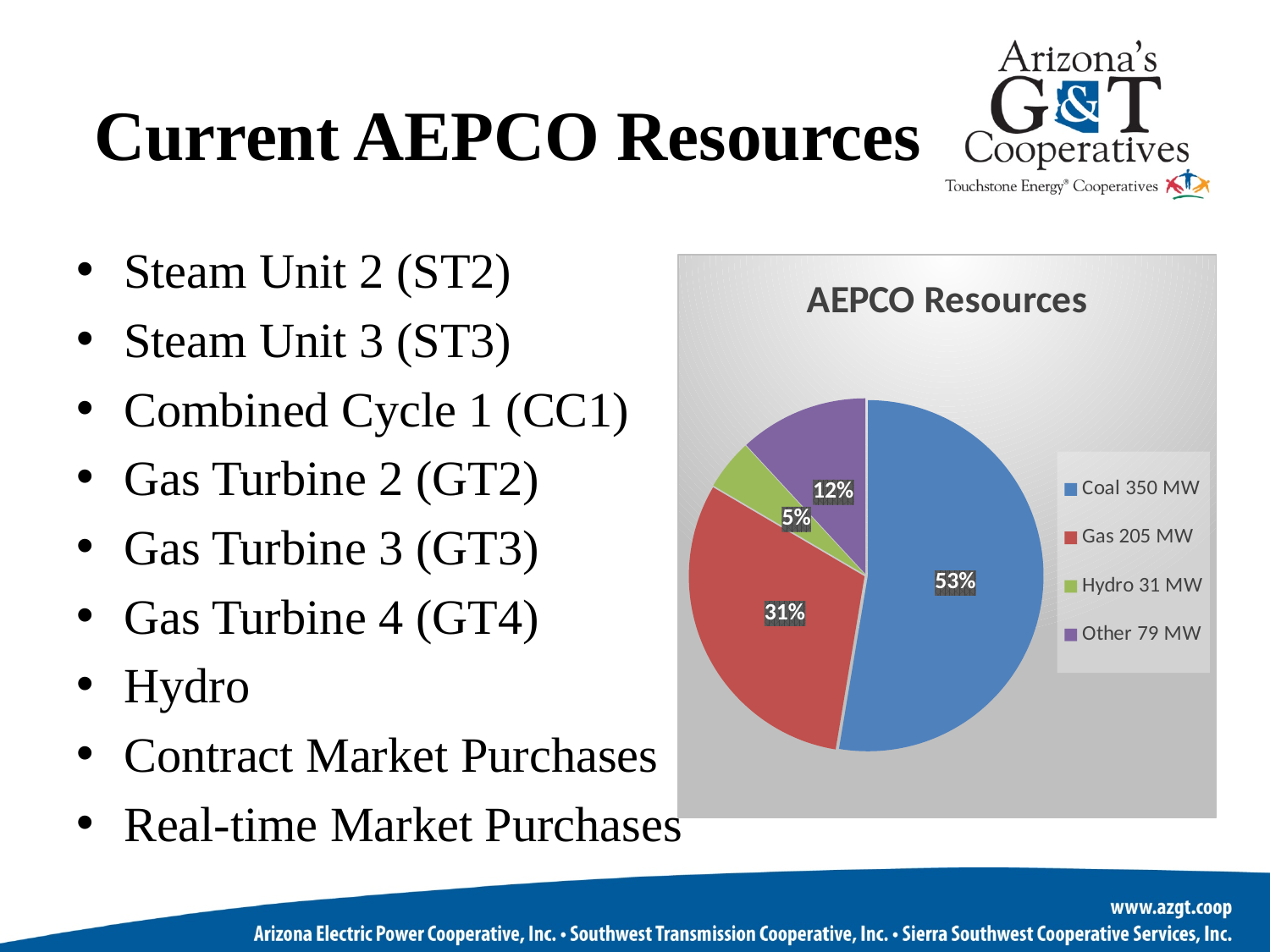
What share of the pie does Coal represent? 53% What share of the pie does Other represent? 12% Which resource has the largest slice of the pie? Coal What share of the pie does Gas represent? 31% What is the title of the chart? AEPCO Resources According to the legend, how many MW does Gas account for? 205 MW What type of chart is shown on the slide? pie chart How many slices does the pie chart have? 4 Which resource has the smallest slice of the pie? Hydro Which slice is larger, Other or Hydro? Other What is the difference in percentage points between the Coal and Gas slices? 22